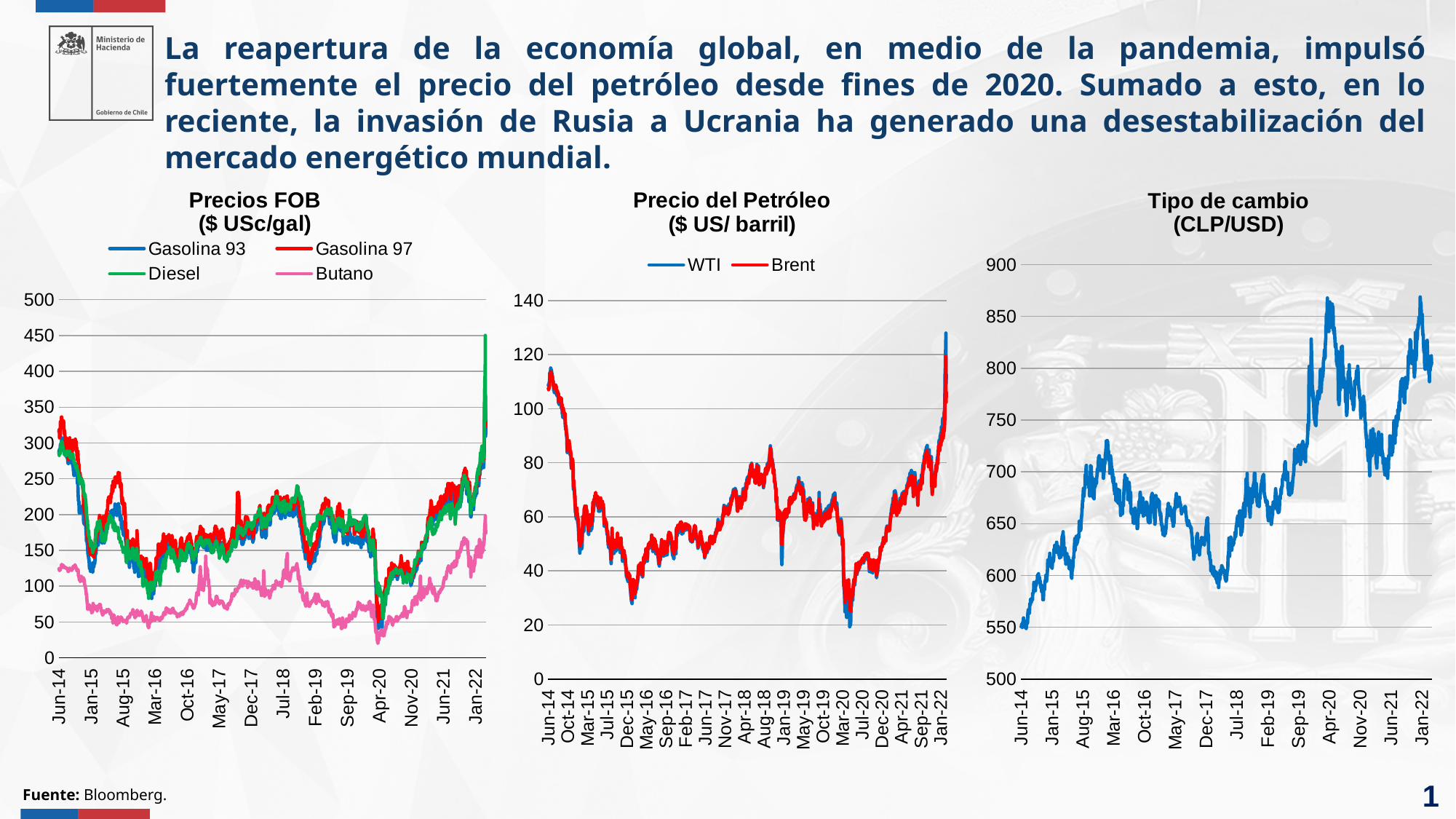
In the 'Precio del Petróleo' chart, is the Brent value at Jun-14 greater or less than 100? greater In the 'Tipo de cambio' chart, is the value at Jun-14 greater or less than 600? less In the 'Tipo de cambio' chart, do values overall rise or fall from Jun-14 to Jan-22? rise What unit is shown in the title of the 'Precio del Petróleo' chart? $ US/ barril In the 'Tipo de cambio' chart, is the value at Jan-22 greater or less than 750? greater In the 'Precio del Petróleo' chart, how many series does the legend list? 2 What kind of chart is the 'Precios FOB' chart? line chart In the 'Precios FOB' chart, which series is drawn in pink? Butano In the 'Precios FOB' chart, how many series does the legend list? 4